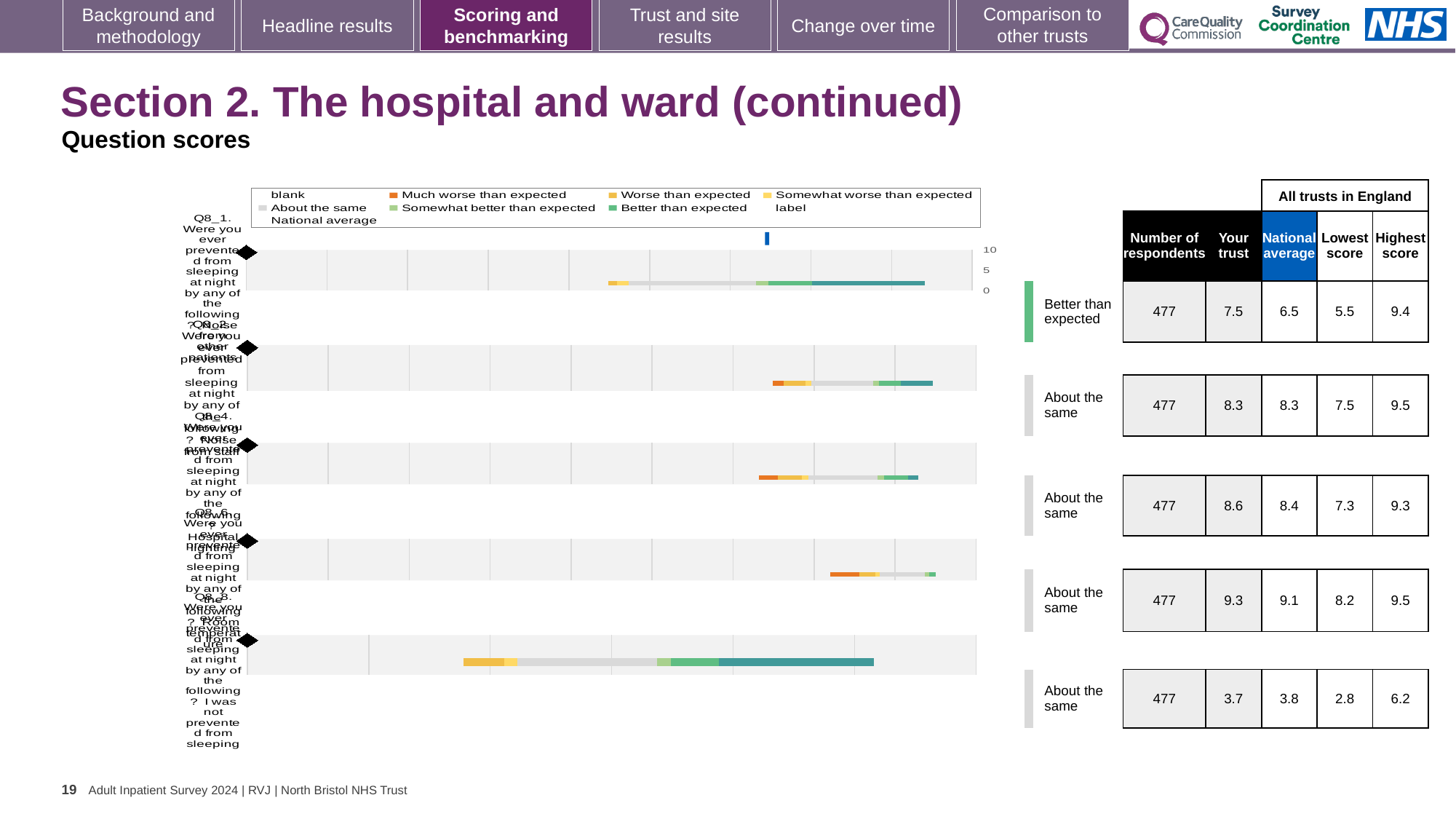
In the table beside the chart, which question row has the lowest 'Your trust' score? Q8_8 (3.7) In the table beside the chart, what is the difference between the highest score (9.4) and the lowest score (5.5) for the first question row? 3.9 Which legend entry is shown in orange? Much worse than expected In the table beside the chart, what is the number of respondents for each question row? 477 In the table beside the chart, what is the 'Your trust' score for the first question row (Q8_1)? 7.5 What kind of chart is shown on the slide? bar chart How many entries does the chart legend list? 9 In the table beside the chart, what is the national average for the last question row (Q8_8)? 3.8 Which legend entry is shown in dark teal? Better than expected How many of the question rows are rated 'About the same' in the benchmark labels next to the chart? 4 In the table beside the chart, which question row has the highest 'Your trust' score? Q8_6 (9.3) How many horizontal bars (question rows) does the chart contain? 5